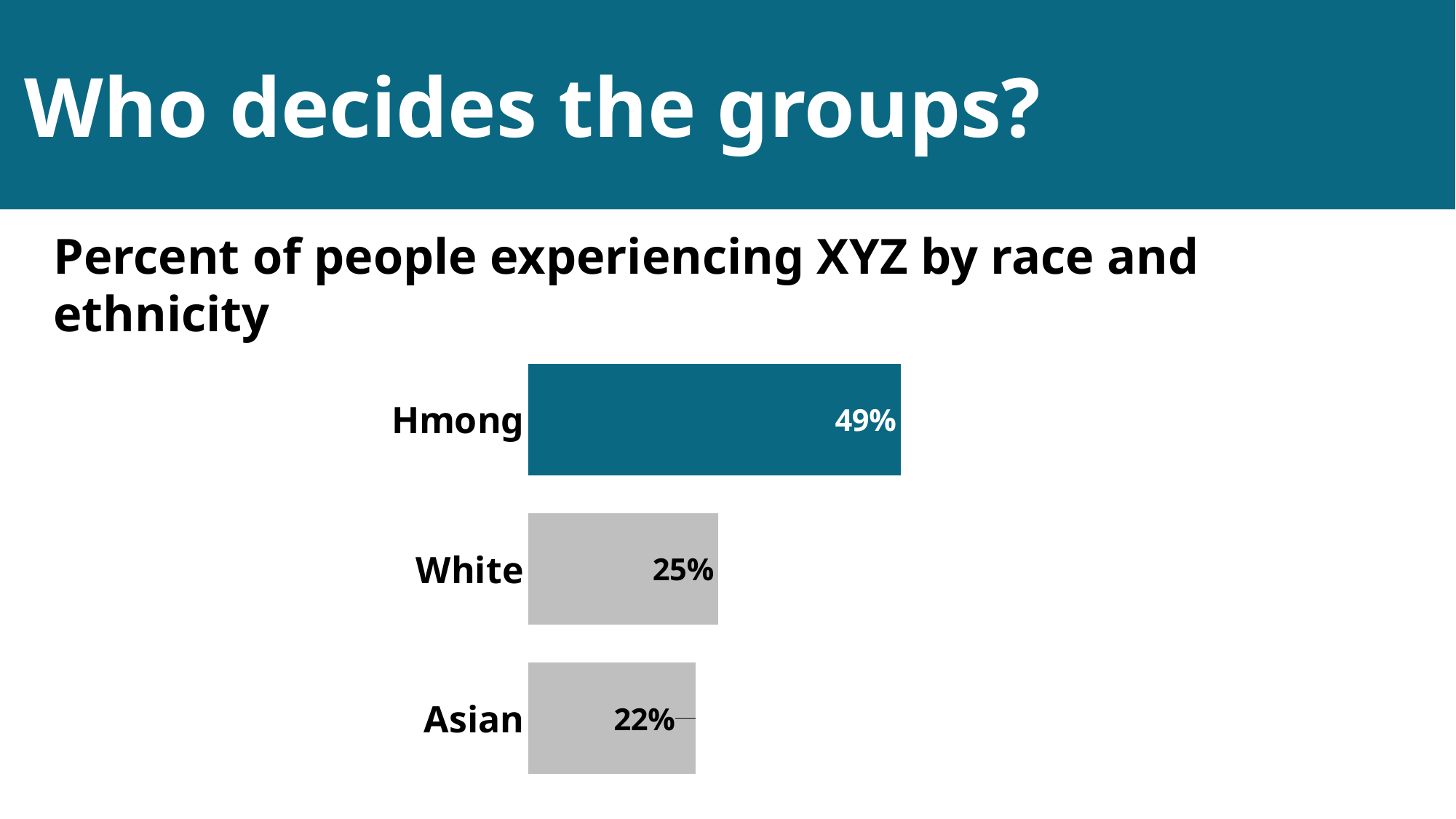
What is the value for Asian? 22% What is the difference between the values for Hmong and White? 24% Which category has the highest value? Hmong Which category has the lowest value? Asian What is the value for Hmong? 49% Which category's bar is coloured teal rather than grey? Hmong What is the title of the chart? Percent of people experiencing XYZ by race and ethnicity What is the difference between the values for White and Asian? 3% What is the value for White? 25% How many categories are shown in the chart? 3 Which is larger, the value for Hmong or the value for Asian? Hmong What kind of chart is shown on the slide? Bar chart